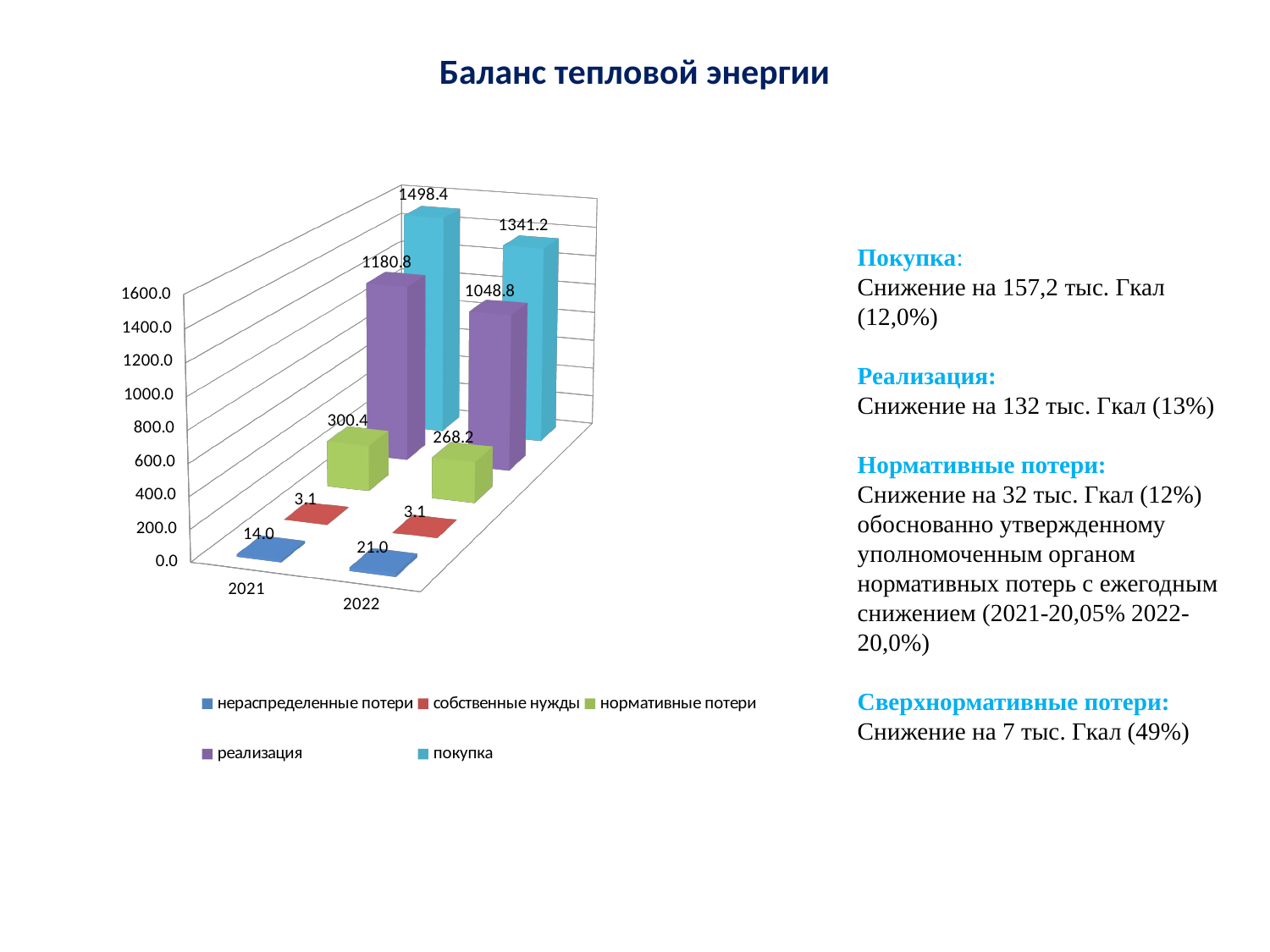
How many series does the legend list? 5 Which is larger: нормативные потери in 2021 or in 2022? 2021 What is the value for собственные нужды in 2021? 3.1 What is the value for покупка in 2021? 1498.4 What kind of chart is shown on the slide? bar chart What is the value for реализация in 2022? 1048.8 Does the value for реализация rise or fall from 2021 to 2022? fall What is the value for нормативные потери in 2021? 300.4 Which series has the highest value in 2022? покупка What is the value for нераспределенные потери in 2022? 21.0 Which series has the lowest value in 2021? собственные нужды What is the difference between the покупка values for 2021 and 2022? 157.2